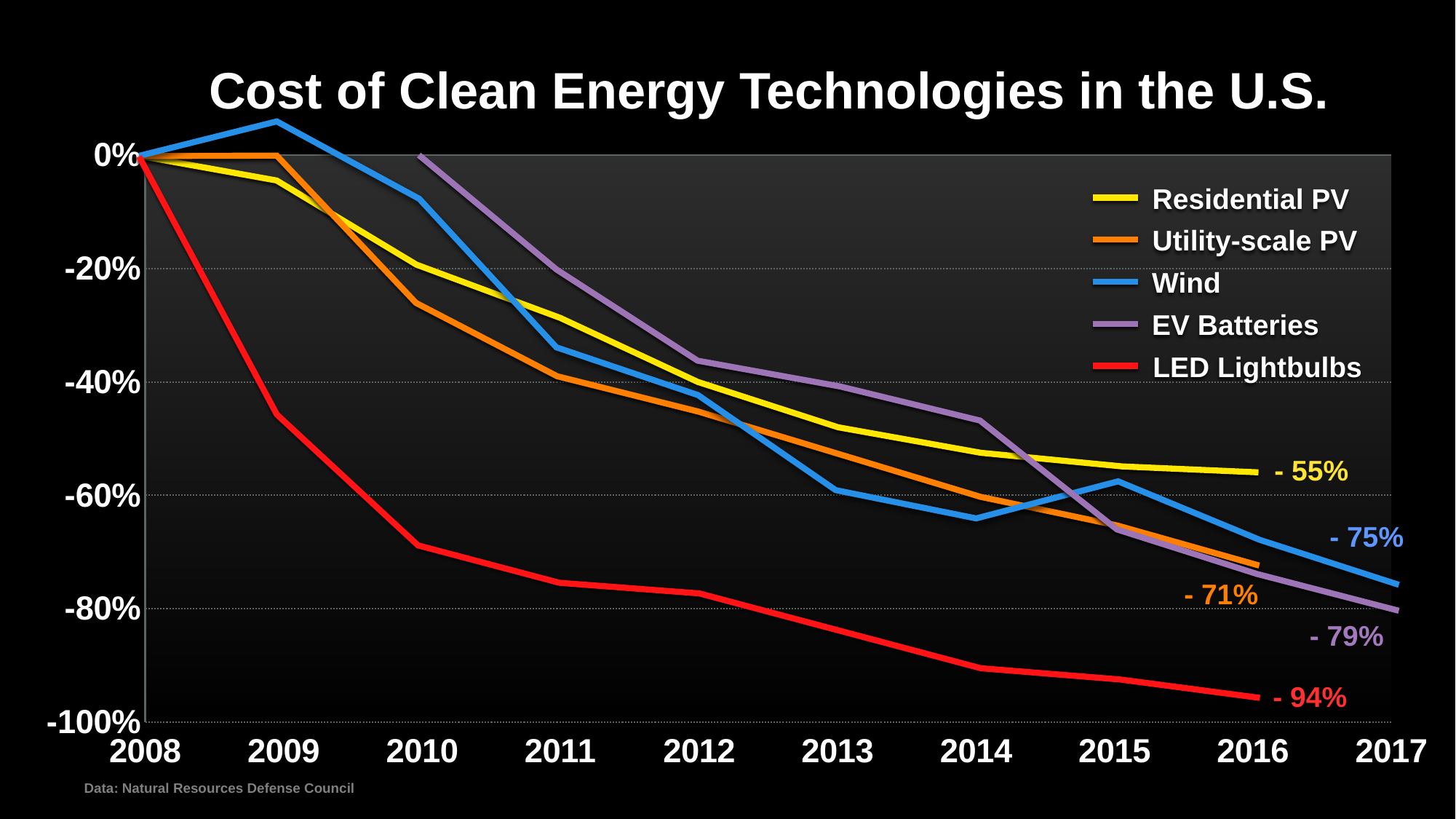
What is the final labelled value for Wind? -75% How many series does the legend list? 5 Do the values for the series generally rise or fall from 2008 to 2017? fall Which series ends at the highest value (smallest cost decline)? Residential PV What is the final labelled value for LED Lightbulbs? -94% What is the final labelled value for Residential PV? -55% What is the difference between the final labelled values for Residential PV (-55%) and LED Lightbulbs (-94%)? 39 percentage points What is the final labelled value for EV Batteries? -79% Is the value for LED Lightbulbs in 2010 greater or less than -60%? less Which series ends at the lowest value (largest cost decline)? LED Lightbulbs What kind of chart is shown on the slide? line chart What is the final labelled value for Utility-scale PV? -71%